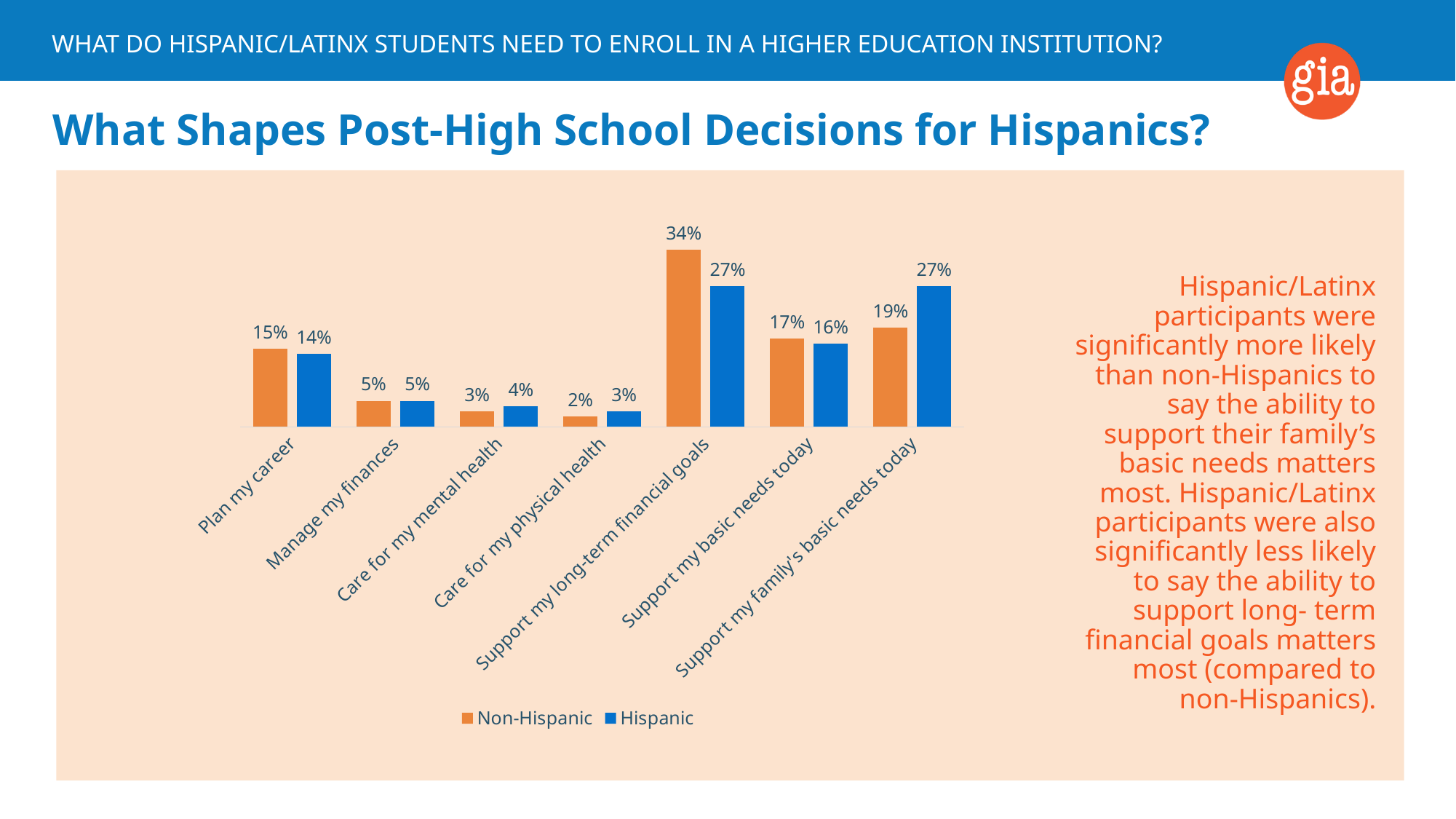
What is the difference between the Hispanic and Non-Hispanic values for "Support my family's basic needs today"? 8% What is the Hispanic value for "Plan my career"? 14% What is the Hispanic value for "Support my family's basic needs today"? 27% What is the difference between the Non-Hispanic and Hispanic values for "Support my long-term financial goals"? 7% How many categories are shown on the x axis? 7 What kind of chart is shown on the slide? Bar chart Which category has the highest Non-Hispanic value? Support my long-term financial goals How many series does the legend list? 2 Which colour represents the Hispanic series in the chart? Blue Which is larger for "Support my basic needs today": the Non-Hispanic value or the Hispanic value? Non-Hispanic Which category has the lowest Non-Hispanic value? Care for my physical health What is the Non-Hispanic value for "Support my long-term financial goals"? 34%